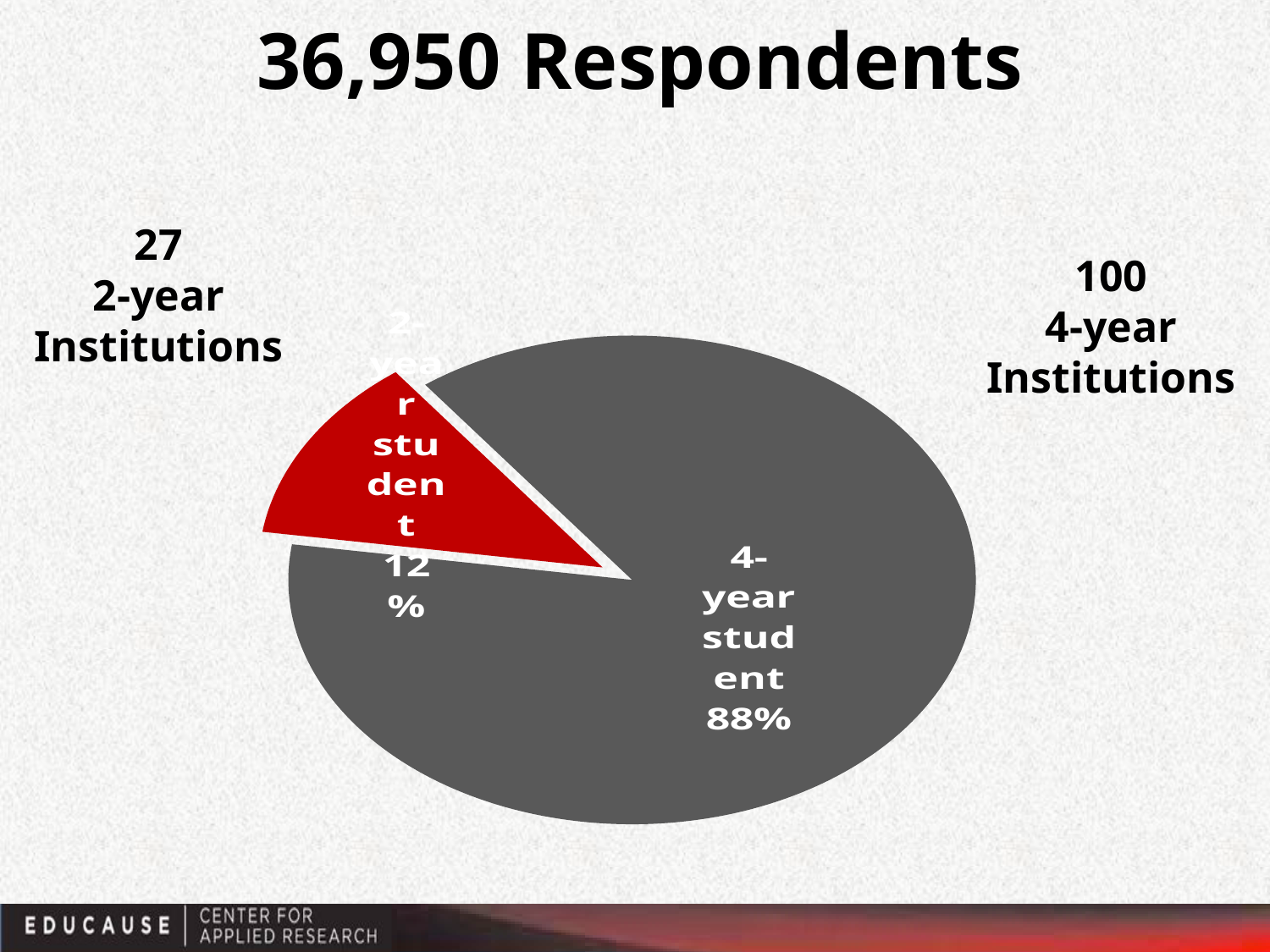
What share of respondents are 4-year students? 88% What colour is the 2-year student slice? red How many slices does the pie chart have? 2 What is the total number of respondents given in the slide title? 36,950 What kind of chart is shown on the slide? pie chart Is the 4-year student share greater or less than 50%? greater Is the 2-year student share greater or less than 25%? less Which is larger, the 2-year student share or the 4-year student share? 4-year student What share of respondents are 2-year students? 12% Which slice of the pie is the smallest? 2-year student Which slice of the pie is the largest? 4-year student What is the difference in percentage points between the 4-year student share and the 2-year student share? 76